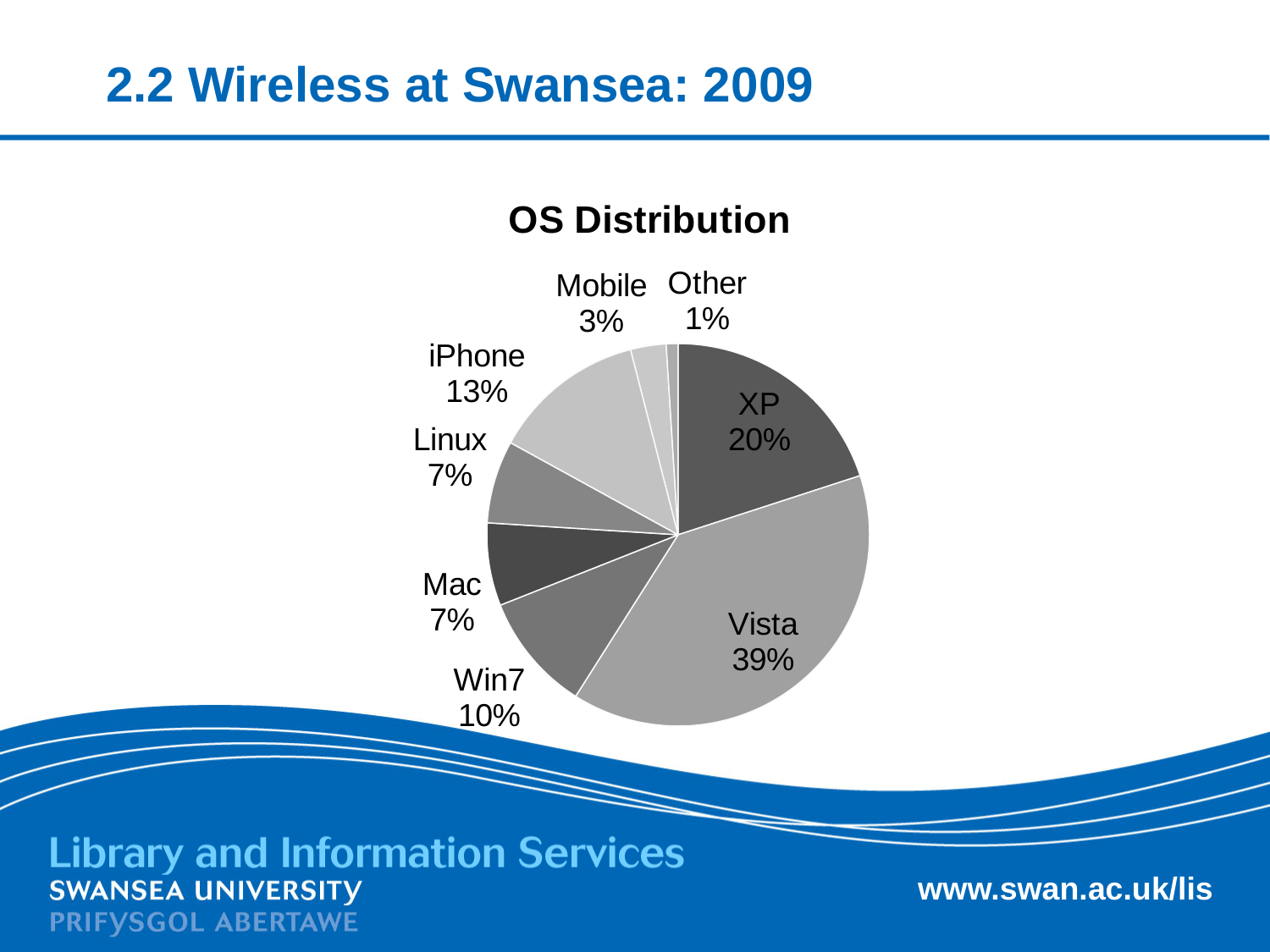
Which category has the largest slice? Vista What is the difference between the Vista and XP shares? 19% Which is larger, iPhone or Win7? iPhone Which category has the smallest slice? Other What is the value for Win7? 10% How many categories are shown in the pie chart? 8 What is the value for iPhone? 13% What kind of chart is shown? Pie chart What is the value for XP? 20% What share of the pie does Vista have? 39% What is the value for Mobile? 3% What is the title of the chart? OS Distribution